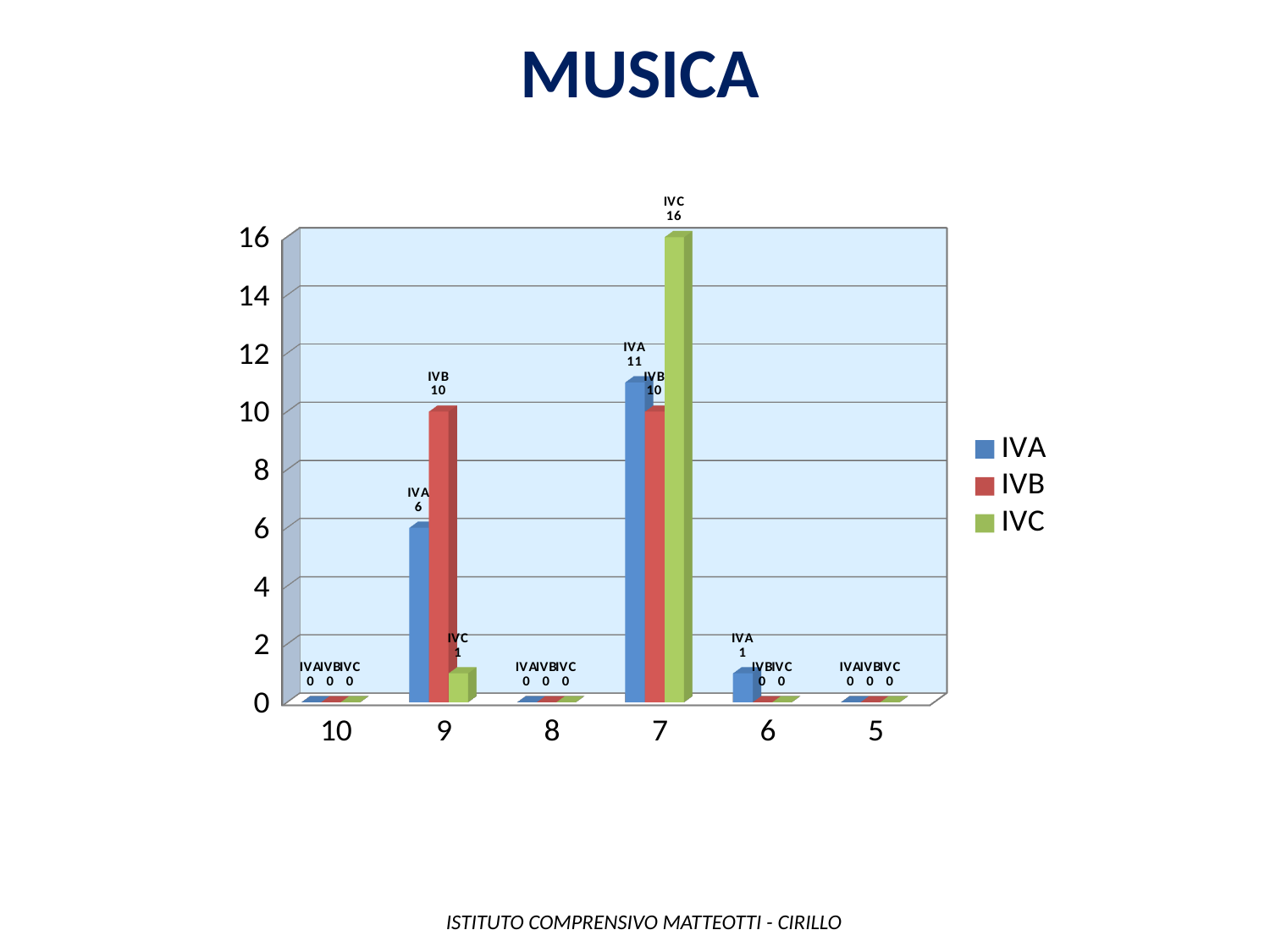
What is the value for IVB at category 9? 10 What is the value for IVC at category 9? 1 Which category has the highest value for IVA? 7 What is the title of the chart? MUSICA What is the total of the IVA, IVB and IVC values at category 7? 37 What kind of chart is shown on the slide? bar chart What is the difference between the IVC value and the IVA value at category 7? 5 Which is larger at category 9: the value for IVA or the value for IVB? IVB How many series does the legend list? 3 What is the value for IVC at category 7? 16 What is the value for IVA at category 6? 1 How many categories are shown on the x axis? 6